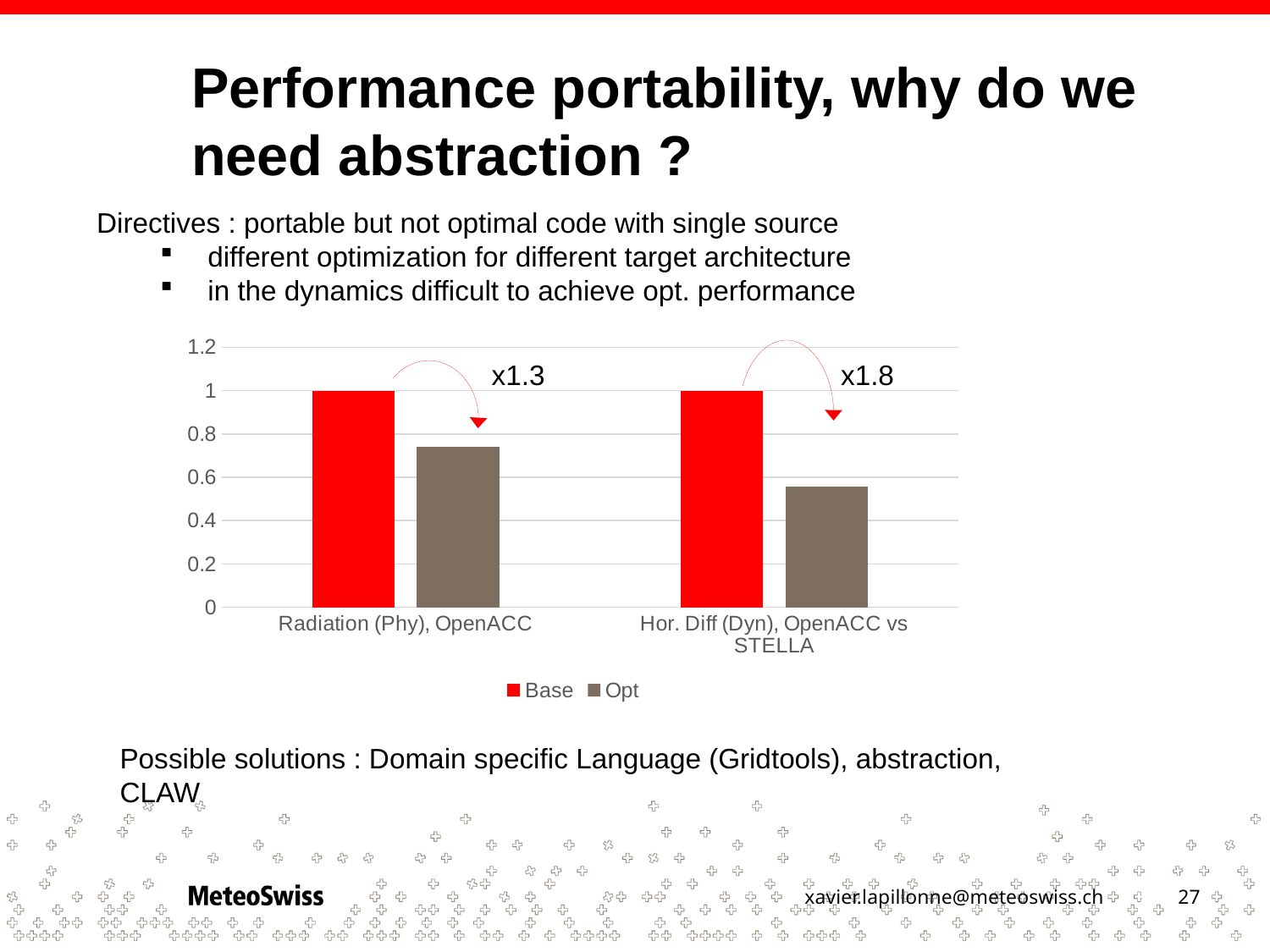
How many series does the chart legend list? 2 What kind of chart is shown on the slide? bar chart Is the Opt value for Radiation (Phy), OpenACC greater or less than 0.8? less What speedup factor is annotated above the Hor. Diff (Dyn), OpenACC vs STELLA bars? x1.8 Is the Opt value for Hor. Diff (Dyn), OpenACC vs STELLA greater or less than 0.6? less Which bar is the lowest in the chart? Opt for Hor. Diff (Dyn), OpenACC vs STELLA For Radiation (Phy), OpenACC, which is larger, the Base value or the Opt value? Base What colour represents the Base series in the chart? red What is the Base value for Hor. Diff (Dyn), OpenACC vs STELLA? 1 What is the Base value for Radiation (Phy), OpenACC? 1 Which has the larger Opt value, Radiation (Phy), OpenACC or Hor. Diff (Dyn), OpenACC vs STELLA? Radiation (Phy), OpenACC How many categories are shown on the x axis of the chart? 2